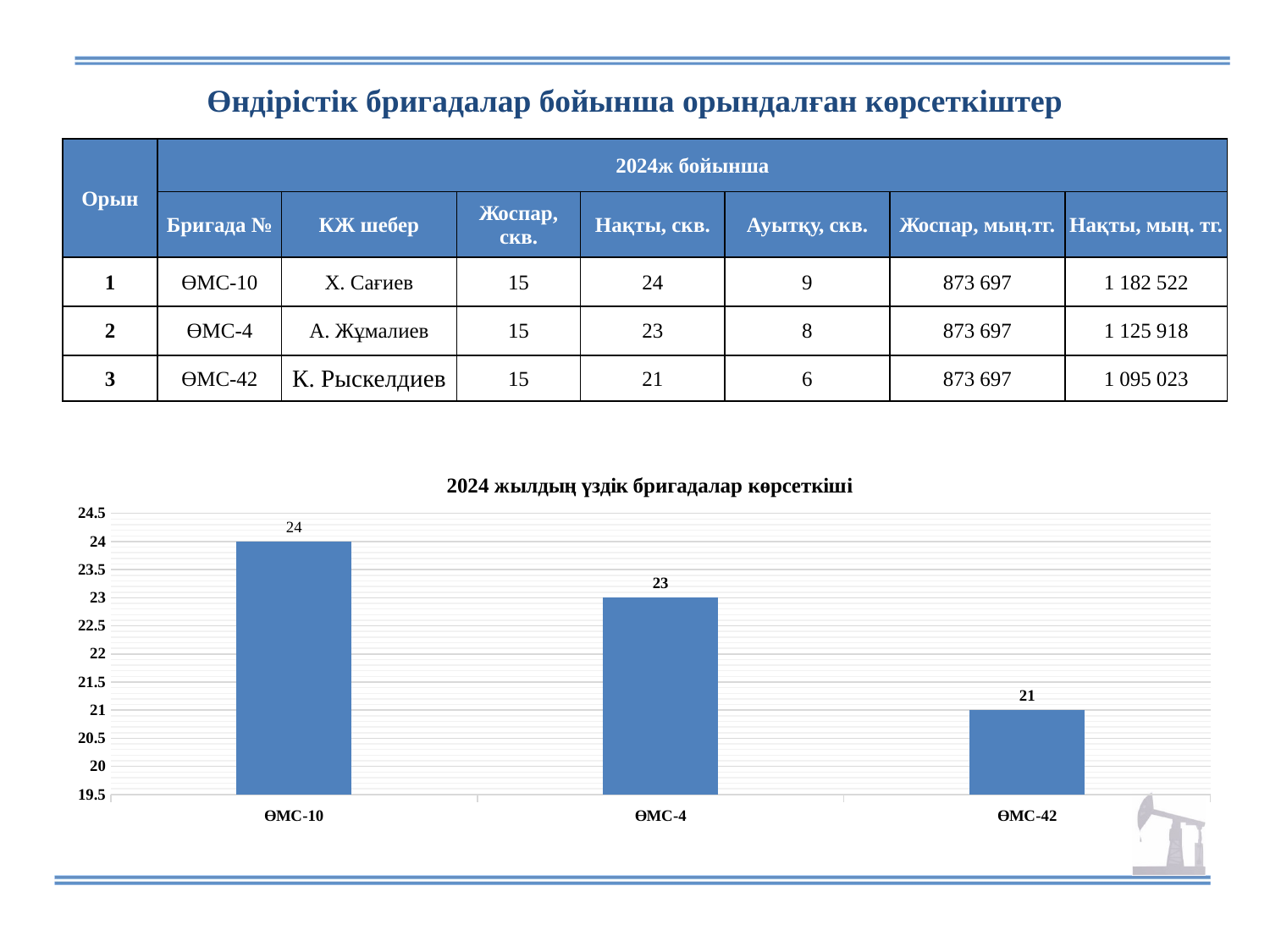
What is the title of the chart? 2024 жылдың үздік бригадалар көрсеткіші How many categories are shown in the chart? 3 What kind of chart is shown on the slide? bar chart What is the difference between the values for ӨМС-10 and ӨМС-42? 3 Which category has the lowest value in the chart? ӨМС-42 What is the value for ӨМС-10 in the chart? 24 Is the value for ӨМС-42 greater or less than 22? less Which is larger, the value for ӨМС-4 or the value for ӨМС-42? ӨМС-4 Which category has the highest value in the chart? ӨМС-10 What is the value for ӨМС-42 in the chart? 21 What is the value for ӨМС-4 in the chart? 23 What is the difference between the values for ӨМС-4 and ӨМС-42? 2